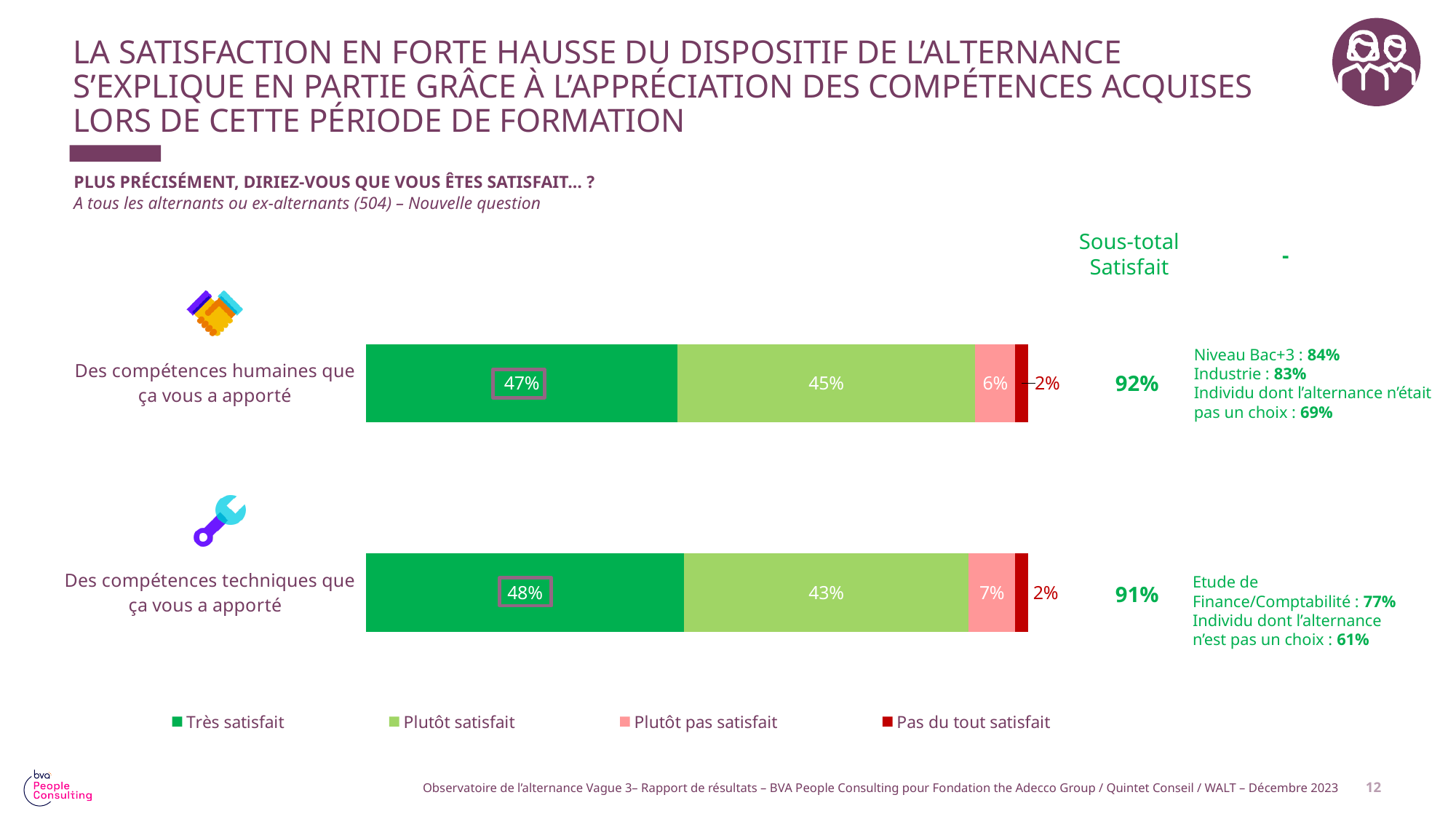
What percentage of respondents are 'Très satisfait' with the human skills (compétences humaines) the alternance brought them? 47% What kind of chart is shown on the slide? Stacked horizontal bar chart How many series does the legend list? 4 Which item has the higher 'Très satisfait' share: human skills or technical skills? Des compétences techniques que ça vous a apporté What is the 'Pas du tout satisfait' value for 'Des compétences humaines que ça vous a apporté'? 2% What is the difference between the 'Plutôt satisfait' values for human skills and technical skills? 2 percentage points What is the combined share of 'Très satisfait' and 'Plutôt satisfait' for technical skills, based on the bar segments? 91% What is the 'Plutôt pas satisfait' value for 'Des compétences techniques que ça vous a apporté'? 7% What percentage of respondents are 'Plutôt satisfait' with the technical skills (compétences techniques) the alternance brought them? 43% How many categories (bars) are shown in the chart? 2 What is the 'Sous-total Satisfait' for 'Des compétences humaines que ça vous a apporté'? 92% What is the 'Sous-total Satisfait' for 'Des compétences techniques que ça vous a apporté'? 91%